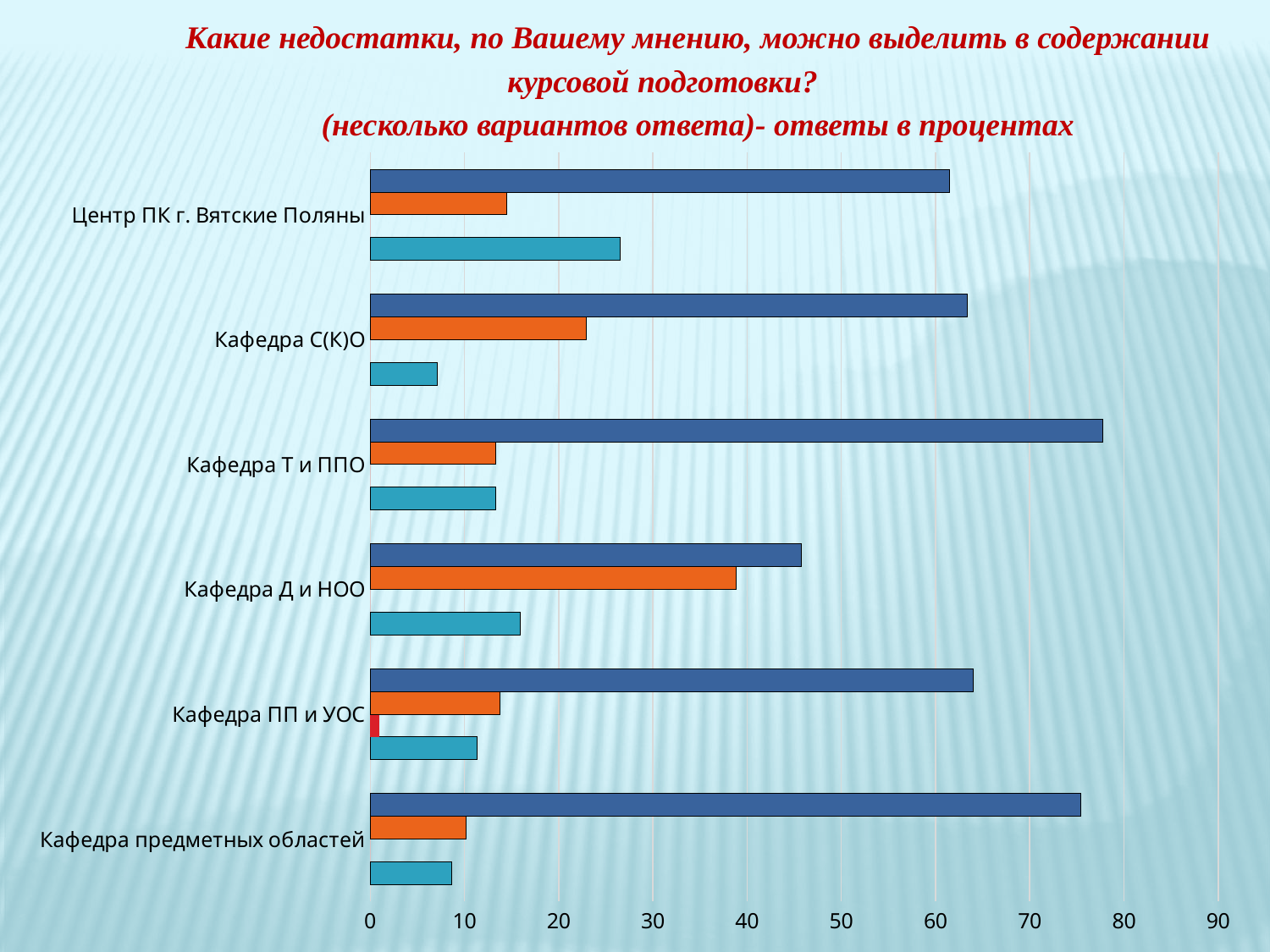
Is the orange bar for Кафедра Д и НОО greater or less than 30? greater Is the light blue bar for Центр ПК г. Вятские Поляны greater or less than 20? greater Which category has the longest dark blue bar? Кафедра Т и ППО Which category has the longest light blue bar? Центр ПК г. Вятские Поляны Which has the larger dark blue bar: Кафедра Т и ППО or Кафедра Д и НОО? Кафедра Т и ППО Is the dark blue bar for Кафедра Д и НОО greater or less than 50? less What kind of chart is shown on the slide? bar chart Which category has the longest orange bar? Кафедра Д и НОО Which category has the shortest dark blue bar? Кафедра Д и НОО How many categories (departments) are listed on the vertical axis of the chart? 6 What is the highest value shown on the horizontal axis of the chart? 90